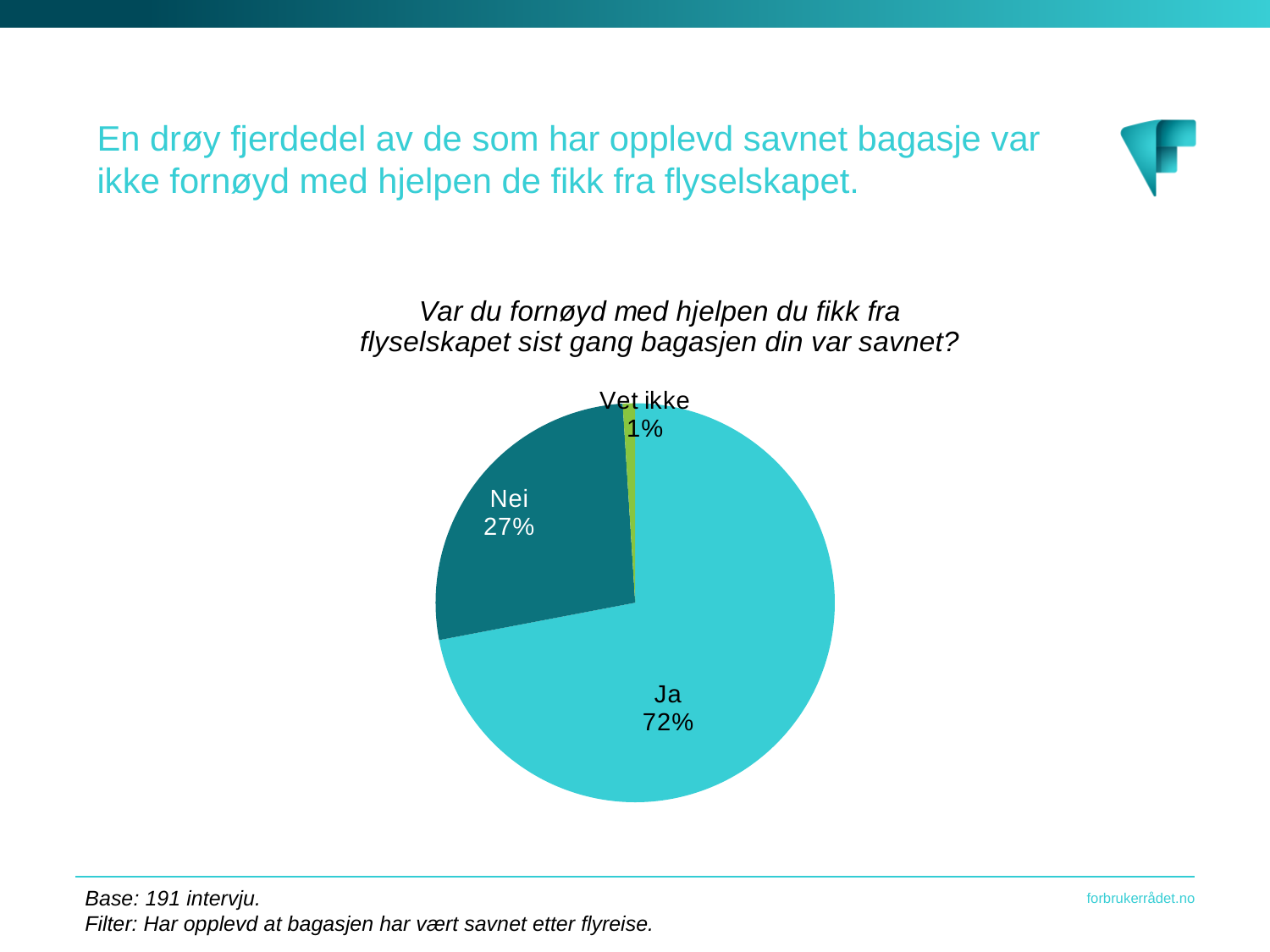
What percentage of respondents answered "Nei"? 27% What share of the pie does the "Nei" slice represent? 27% How many slices does the pie chart have? 3 How many interviews form the base for the chart? 191 Which is larger, the share for "Nei" or the share for "Vet ikke"? Nei Which category has the smallest slice of the pie? Vet ikke What percentage of respondents answered "Vet ikke"? 1% Which category has the largest slice of the pie? Ja What percentage of respondents answered "Ja"? 72% What is the title of the chart? Var du fornøyd med hjelpen du fikk fra flyselskapet sist gang bagasjen din var savnet? What kind of chart is shown on the slide? pie chart What is the difference in percentage points between "Ja" and "Nei"? 45